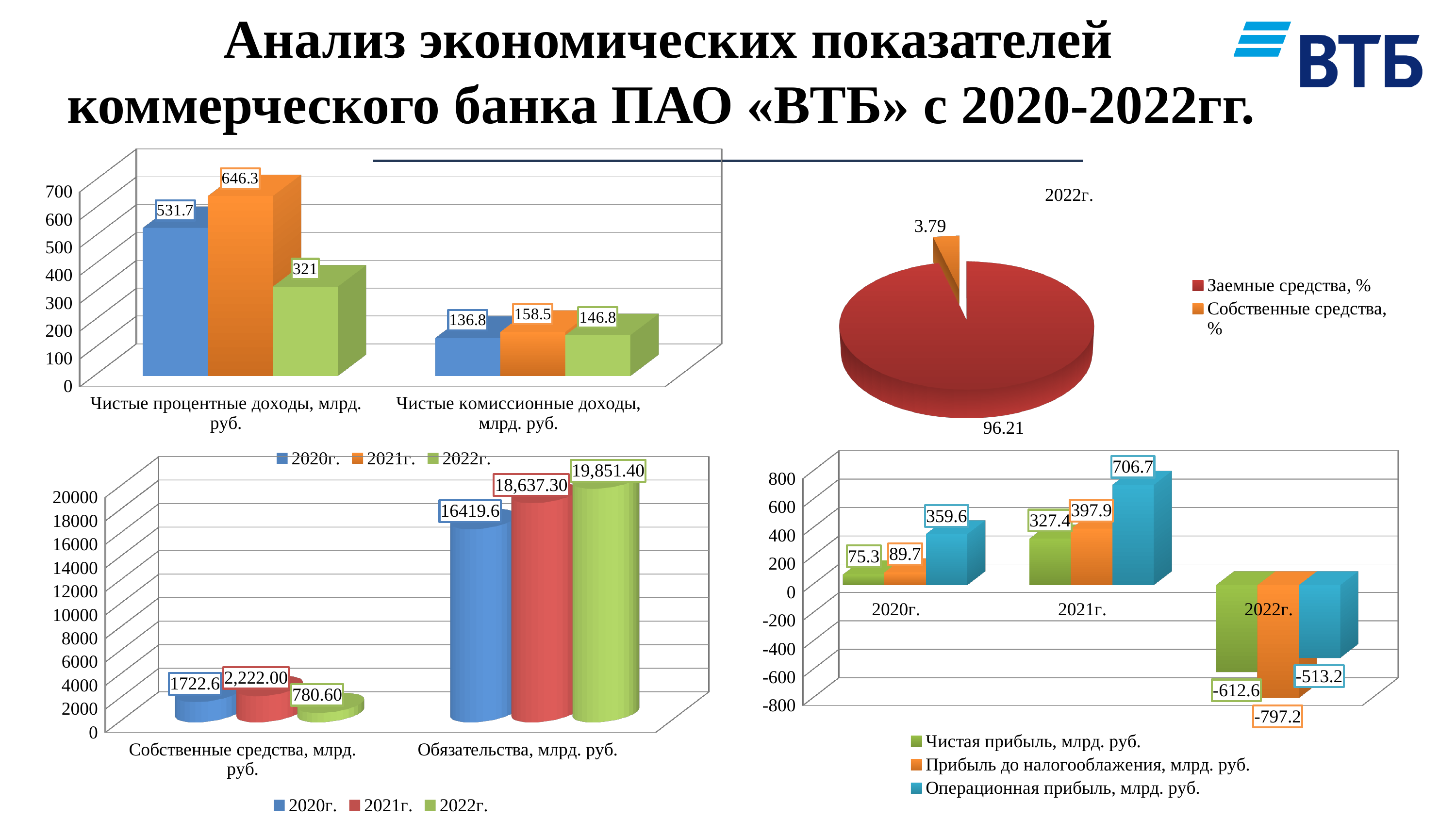
In the bottom-right bar chart, what is the value of Операционная прибыль, млрд. руб. for 2021г.? 706.7 In the top-left bar chart, what is the value of Чистые комиссионные доходы, млрд. руб. for 2020г.? 136.8 In the top-left bar chart, what is the value of Чистые процентные доходы, млрд. руб. for 2021г.? 646.3 In the top-left bar chart, what is the difference between the 2021г. and 2022г. values for Чистые процентные доходы, млрд. руб.? 325.3 In the bottom-right bar chart, what is the value of Прибыль до налогооблажения, млрд. руб. for 2022г.? -797.2 In the top-right pie chart, what share does Заемные средства, % have? 96.21 In the bottom-left bar chart, what is the value of Обязательства, млрд. руб. for 2022г.? 19,851.40 In the top-left bar chart, which year has the lowest value for Чистые процентные доходы, млрд. руб.? 2022г. In the bottom-left bar chart, what is the value of Собственные средства, млрд. руб. for 2021г.? 2,222.00 In the top-right pie chart, what share does Собственные средства, % have? 3.79 How many series does the legend of the bottom-right bar chart list? 3 In the bottom-left bar chart, which year has the highest value for Обязательства, млрд. руб.? 2022г.